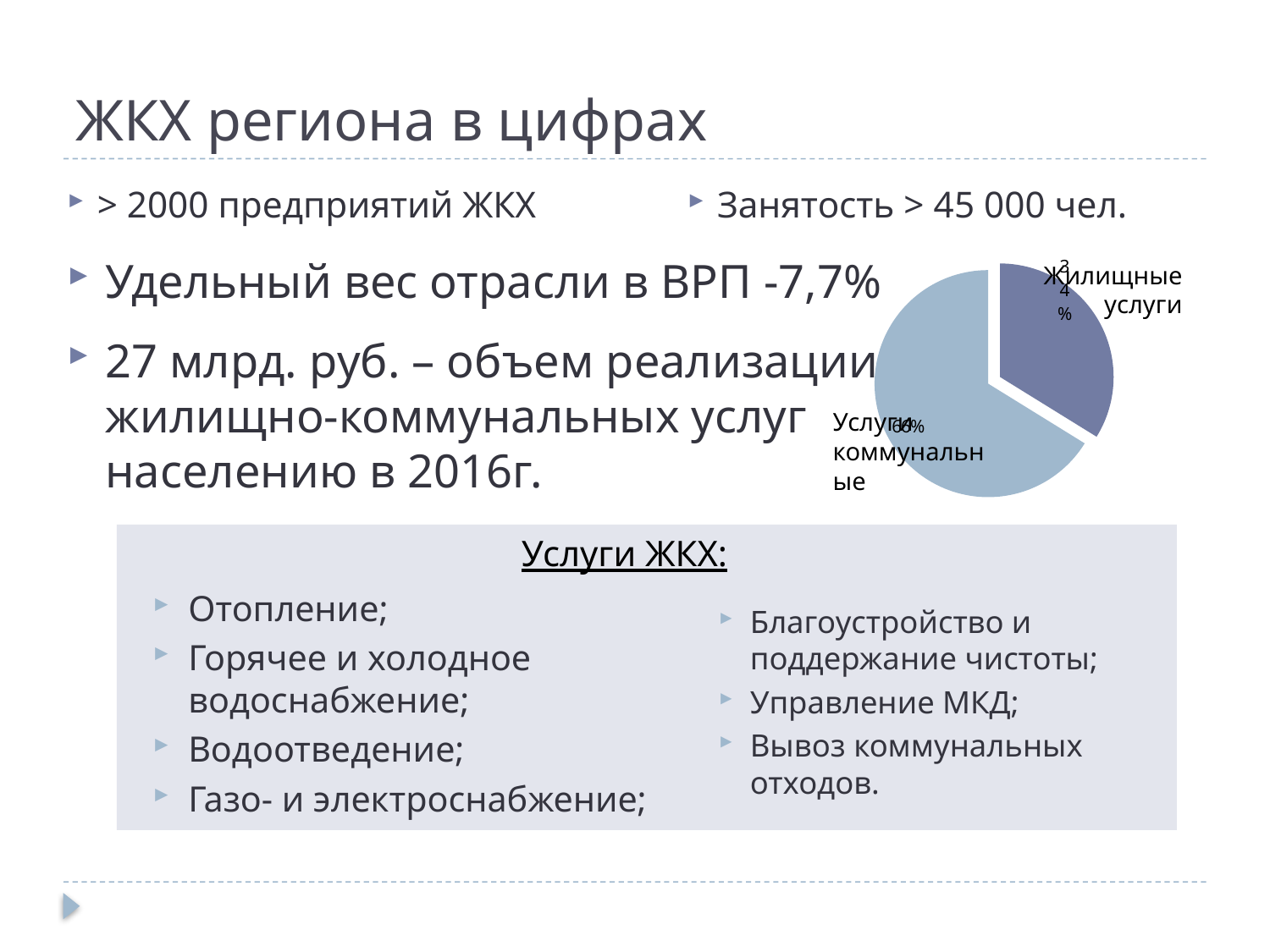
By how many percentage points does the Услуги коммунальные slice exceed the Жилищные услуги slice? 32 Which category has the smallest slice in the pie chart? Жилищные услуги How many slices does the pie chart have? 2 Does the Услуги коммунальные slice take up more or less than half of the pie chart? more What share of the pie chart is Жилищные услуги? 34% Which is larger in the pie chart, Жилищные услуги or Услуги коммунальные? Услуги коммунальные Which slice of the pie chart is drawn in the darker blue colour? Жилищные услуги Which category has the largest slice in the pie chart? Услуги коммунальные What kind of chart is shown on the slide? pie chart What share of the pie chart is Услуги коммунальные? 66%